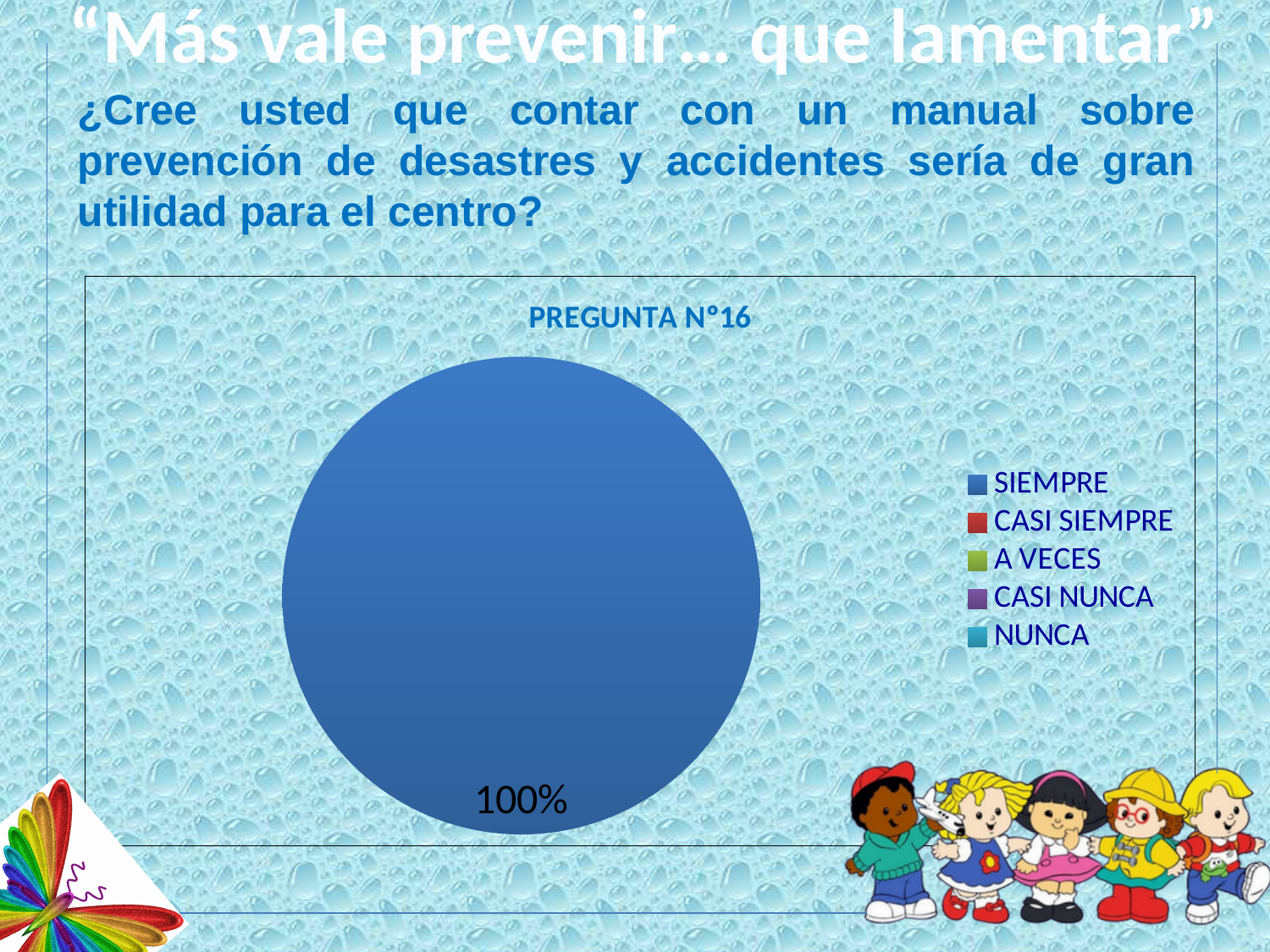
What colour is used for the SIEMPRE category in the legend? blue Which category accounts for the entire pie? SIEMPRE What percentage is printed as the data label on the pie chart? 100% How many entries does the chart's legend list? 5 How many visible slices does the pie chart have? 1 What is the title of the chart? PREGUNTA N°16 Which legend entry is listed first? SIEMPRE What kind of chart is shown on the slide? pie chart Is the share for SIEMPRE greater or less than 50%? greater What share of the pie does SIEMPRE represent? 100%